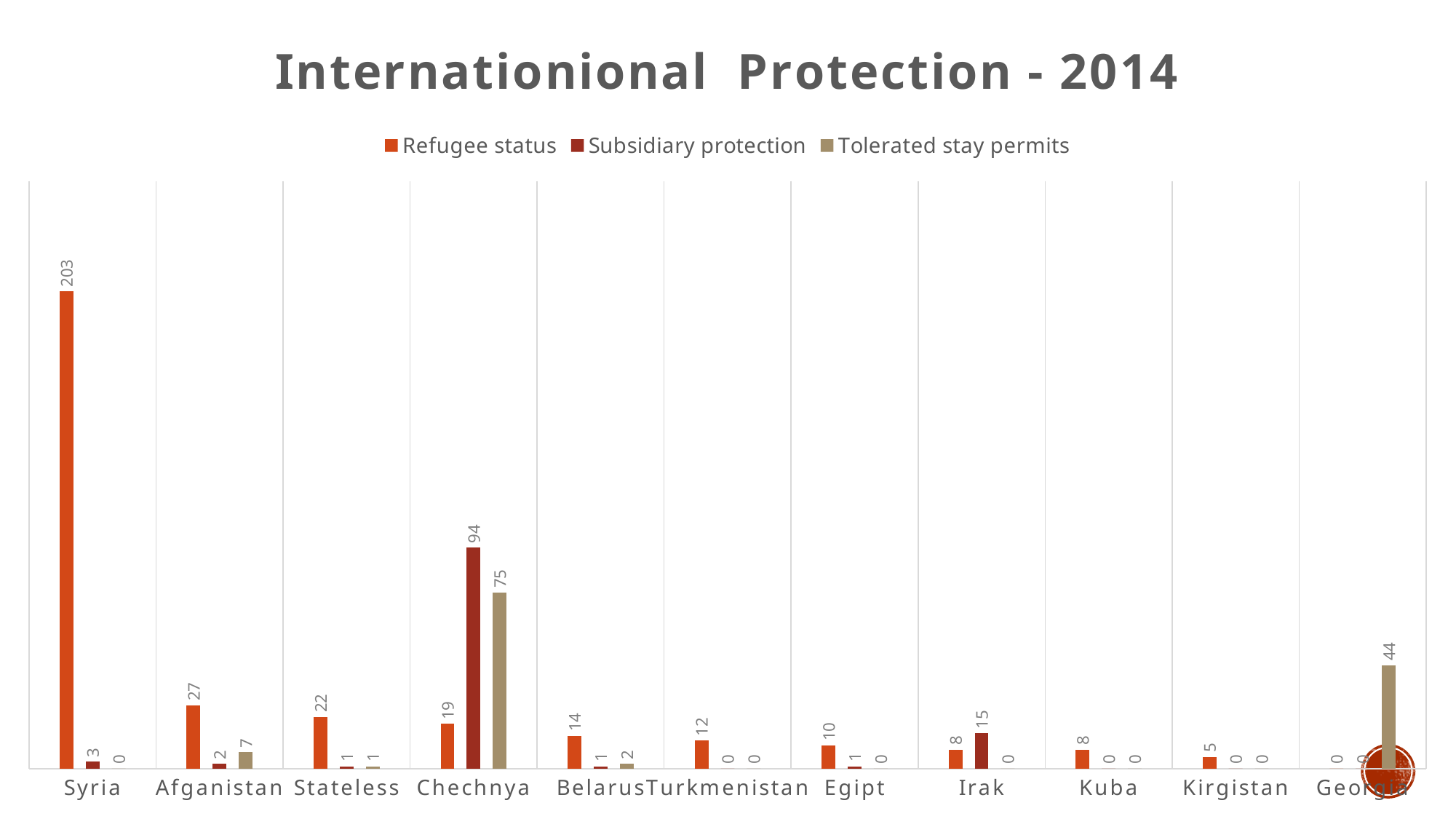
How many countries or categories are shown on the x axis? 11 What is the Tolerated stay permits value for Georgia? 44 What is the Refugee status value for Syria? 203 Which category has the highest Tolerated stay permits value? Chechnya Which country has the highest Refugee status value? Syria Which is larger for Chechnya: Refugee status or Subsidiary protection? Subsidiary protection What is the Subsidiary protection value for Irak? 15 What is the difference between the Subsidiary protection and Tolerated stay permits values for Chechnya? 19 What kind of chart is shown on the slide? Bar chart How many series does the legend list? 3 What is the difference between the Refugee status values for Afganistan and Stateless? 5 What is the Subsidiary protection value for Chechnya? 94